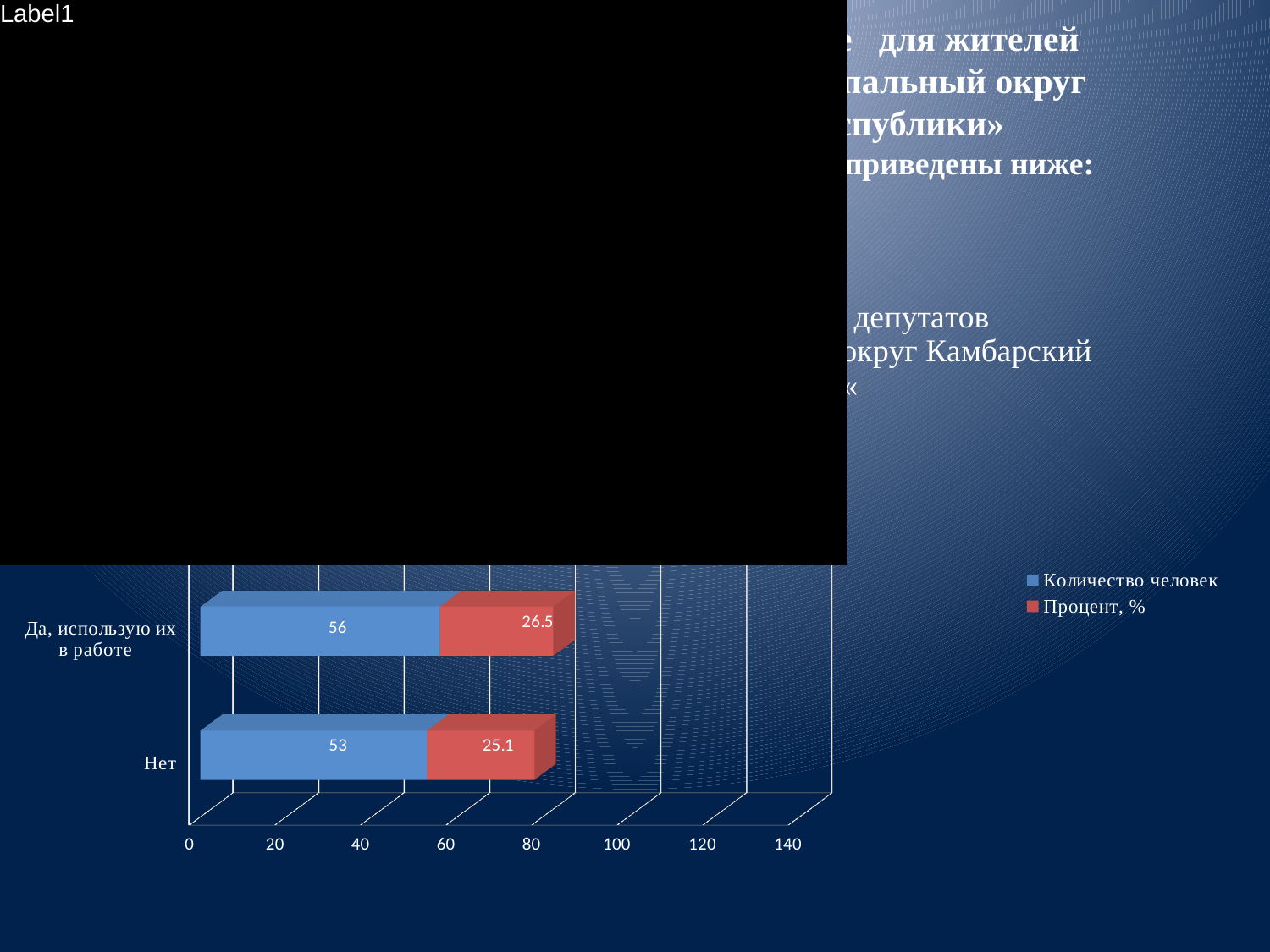
What is the value of "Количество человек" for "Нет"? 53 What is the total of the stacked bar for "Нет"? 78.1 How many series does the legend list? 2 What is the total of the stacked bar for "Да, использую их в работе"? 82.5 What is the value of "Процент, %" for "Да, использую их в работе"? 26.5 What is the value of "Процент, %" for "Нет"? 25.1 What is the difference in "Количество человек" between "Да, использую их в работе" and "Нет"? 3 Which category has the lower "Процент, %" value? Нет Which category has the higher "Количество человек" value? Да, использую их в работе How many categories are shown on the chart? 2 What is the value of "Количество человек" for "Да, использую их в работе"? 56 What kind of chart is shown on the slide? Stacked bar chart